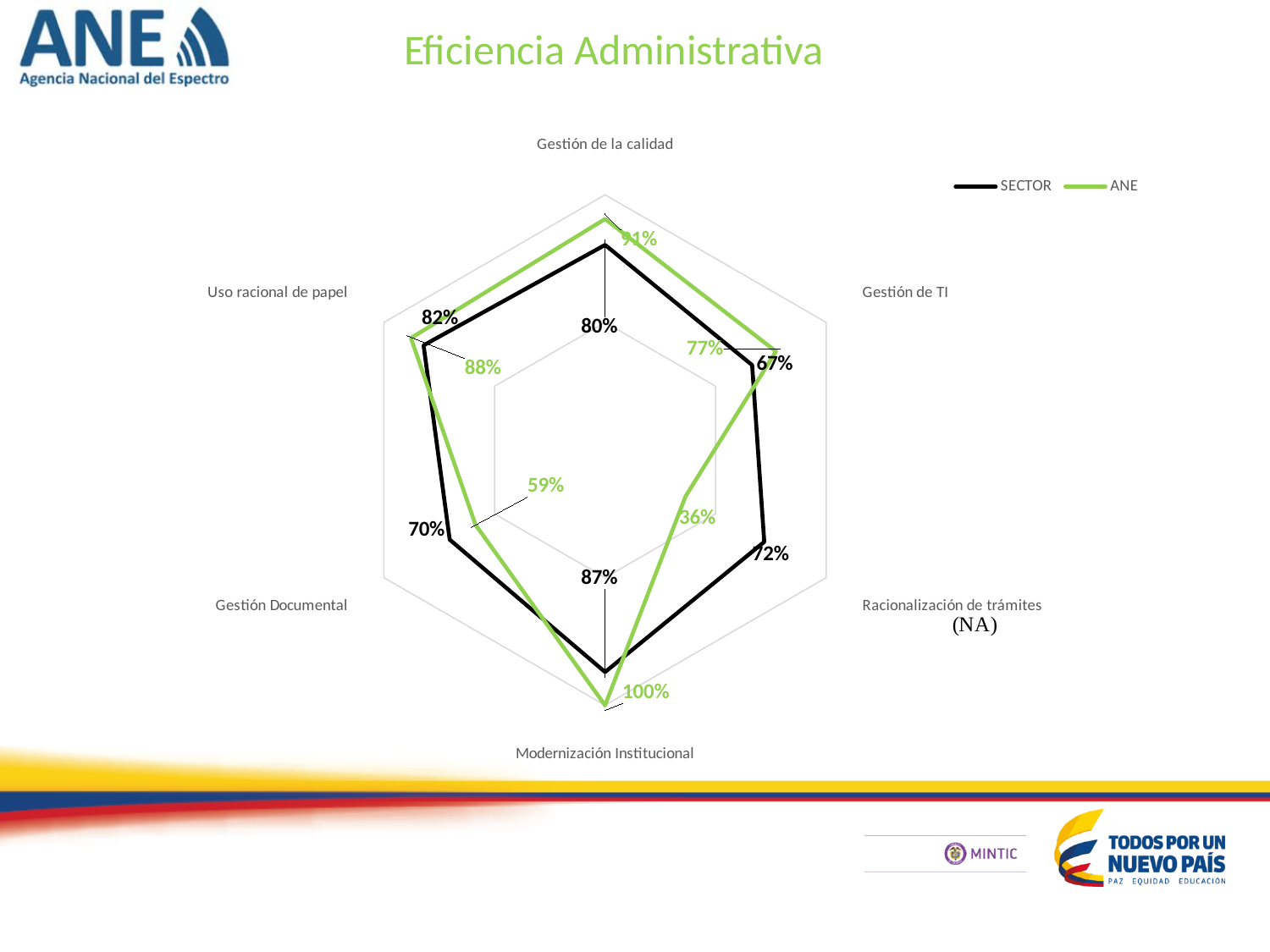
What is the SECTOR value for Gestión de TI? 67% Which category has the lowest ANE value? Racionalización de trámites How many series does the legend list? 2 What kind of chart is shown on the slide? Radar chart What is the SECTOR value for Racionalización de trámites? 72% What is the ANE value for Modernización Institucional? 100% Which category has the highest ANE value? Modernización Institucional For Uso racional de papel, which series has the larger value, SECTOR or ANE? ANE What is the ANE value for Gestión Documental? 59% What is the difference between the ANE and SECTOR values for Gestión de la calidad? 11% What is the title of the chart on the slide? Eficiencia Administrativa How many categories (axes) does the radar chart have? 6